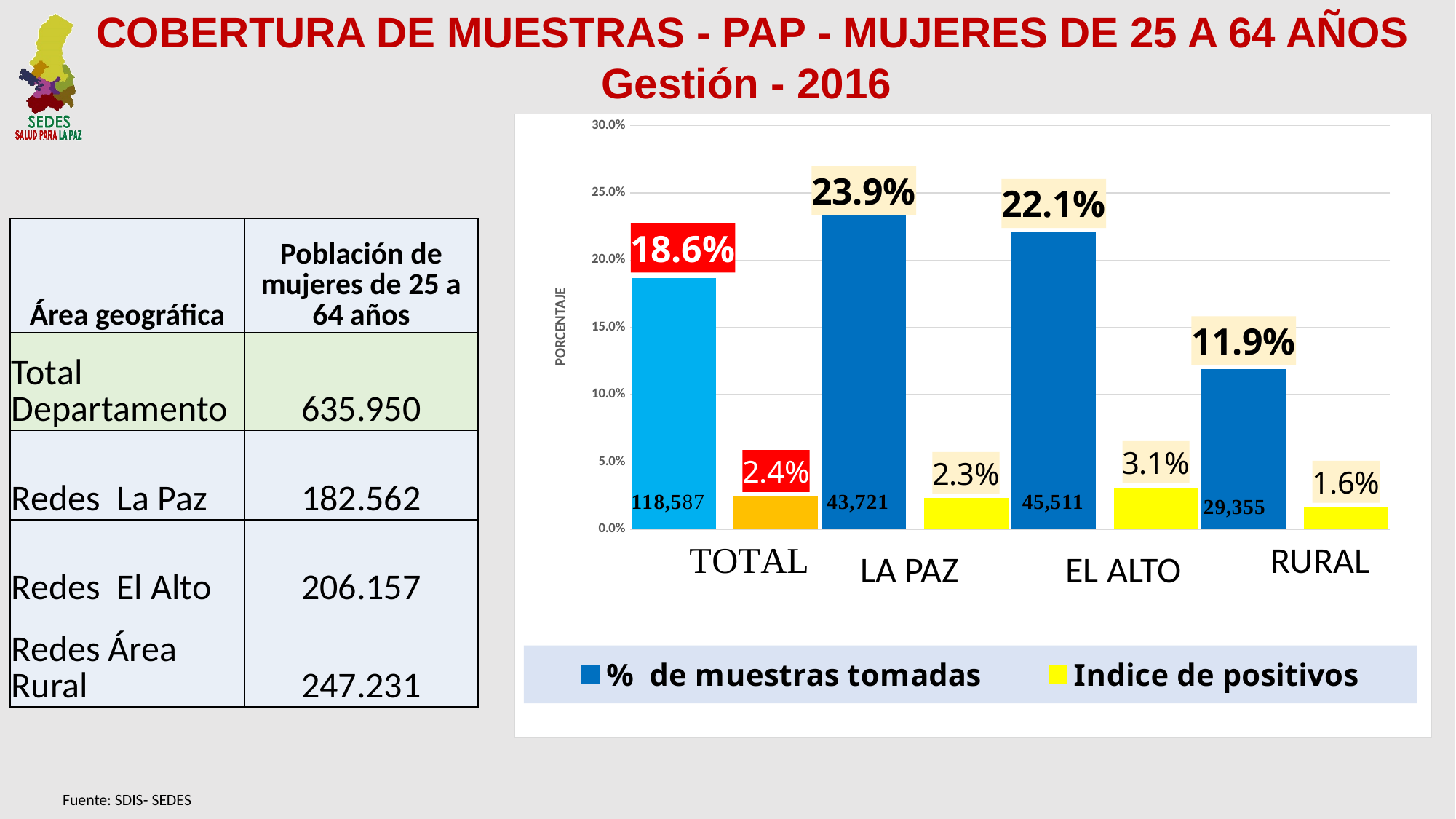
Which category has the lowest 'Indice de positivos'? RURAL Which is larger, the '% de muestras tomadas' for EL ALTO or for RURAL? EL ALTO What is the difference between the '% de muestras tomadas' for LA PAZ and EL ALTO? 1.8% Which category has the highest '% de muestras tomadas'? LA PAZ What is the value of 'Indice de positivos' for EL ALTO? 3.1% What kind of chart is shown on the slide? bar chart How many series does the chart legend list? 2 How many categories are shown on the x axis of the chart? 4 What is the value of '% de muestras tomadas' for RURAL? 11.9% Is the '% de muestras tomadas' for TOTAL greater or less than 20.0%? less What is the value of '% de muestras tomadas' for LA PAZ? 23.9% What is the value of 'Indice de positivos' for TOTAL? 2.4%